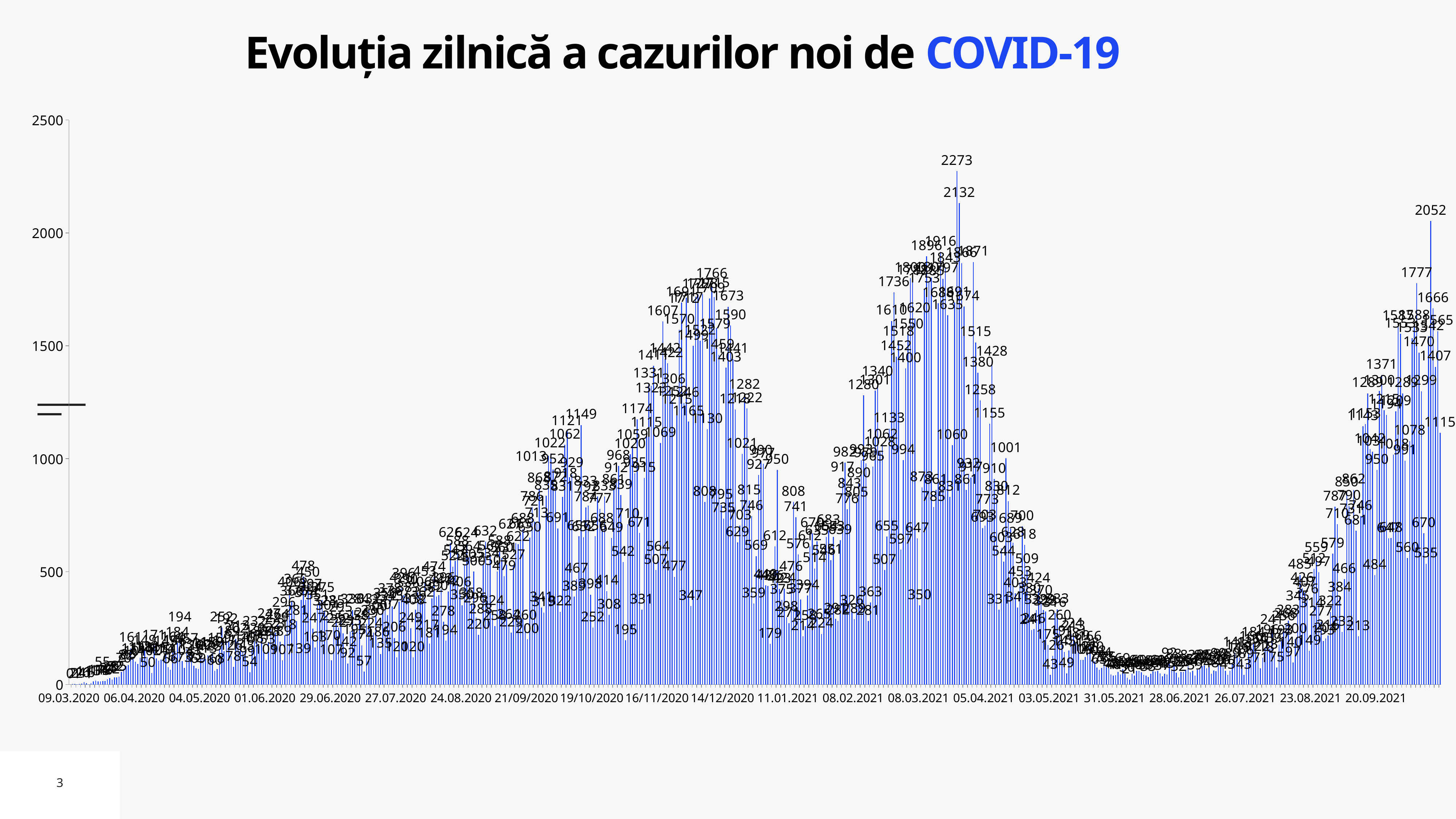
What is the value labelled on the last (rightmost) bar of the chart? 1115 Which is larger, the peak value 2273 or the rightmost bar value 2052? 2273 What is the second-highest value labelled near the peak around 05.04.2021? 2132 What kind of chart is shown on the slide? bar chart What is the difference between the highest labelled value (2273) and the rightmost bar value (2052)? 221 What is the maximum value shown on the vertical axis? 2500 Do the values rise or fall between 05.04.2021 and 31.05.2021? fall What is the difference between the two highest labelled values, 2273 and 2132? 141 What is the highest daily value labelled on the chart? 2273 Is the highest bar on the chart greater or less than 2000? greater Are the values around 31.05.2021 greater or less than 500? less What is the title of the chart? Evoluția zilnică a cazurilor noi de COVID-19